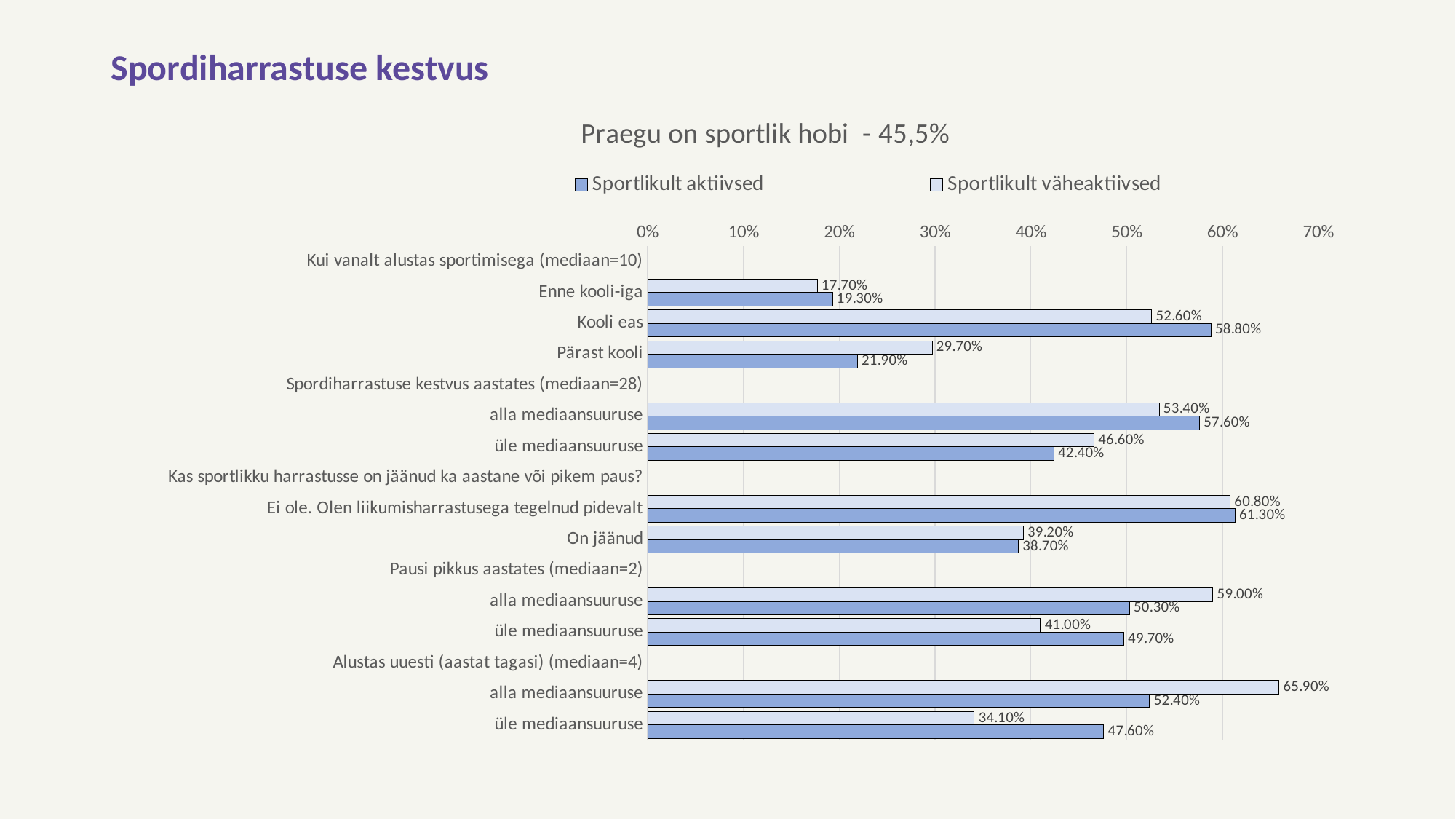
What is the value for 'Sportlikult väheaktiivsed' in the 'Pärast kooli' category? 29.70% What is the value for 'Sportlikult väheaktiivsed' in the 'Ei ole. Olen liikumisharrastusega tegelnud pidevalt' category? 60.80% What is the difference between 'Sportlikult aktiivsed' and 'Sportlikult väheaktiivsed' in the 'Kooli eas' category? 6.20% What type of chart is shown on the slide? bar chart Is the 'Sportlikult väheaktiivsed' value for 'Enne kooli-iga' greater or less than 20%? less Which category has the highest value for 'Sportlikult väheaktiivsed'? alla mediaansuuruse (under 'Alustas uuesti (aastat tagasi) (mediaan=4)') What is the title of the chart? Praegu on sportlik hobi - 45,5% What is the value for 'Sportlikult aktiivsed' in the 'On jäänud' category? 38.70% In the 'Pärast kooli' category, which series has the larger value: 'Sportlikult aktiivsed' or 'Sportlikult väheaktiivsed'? Sportlikult väheaktiivsed What is the value for 'Sportlikult aktiivsed' in the 'Kooli eas' category? 58.80% How many series does the chart legend list? 2 Which category has the lowest value for 'Sportlikult aktiivsed'? Enne kooli-iga